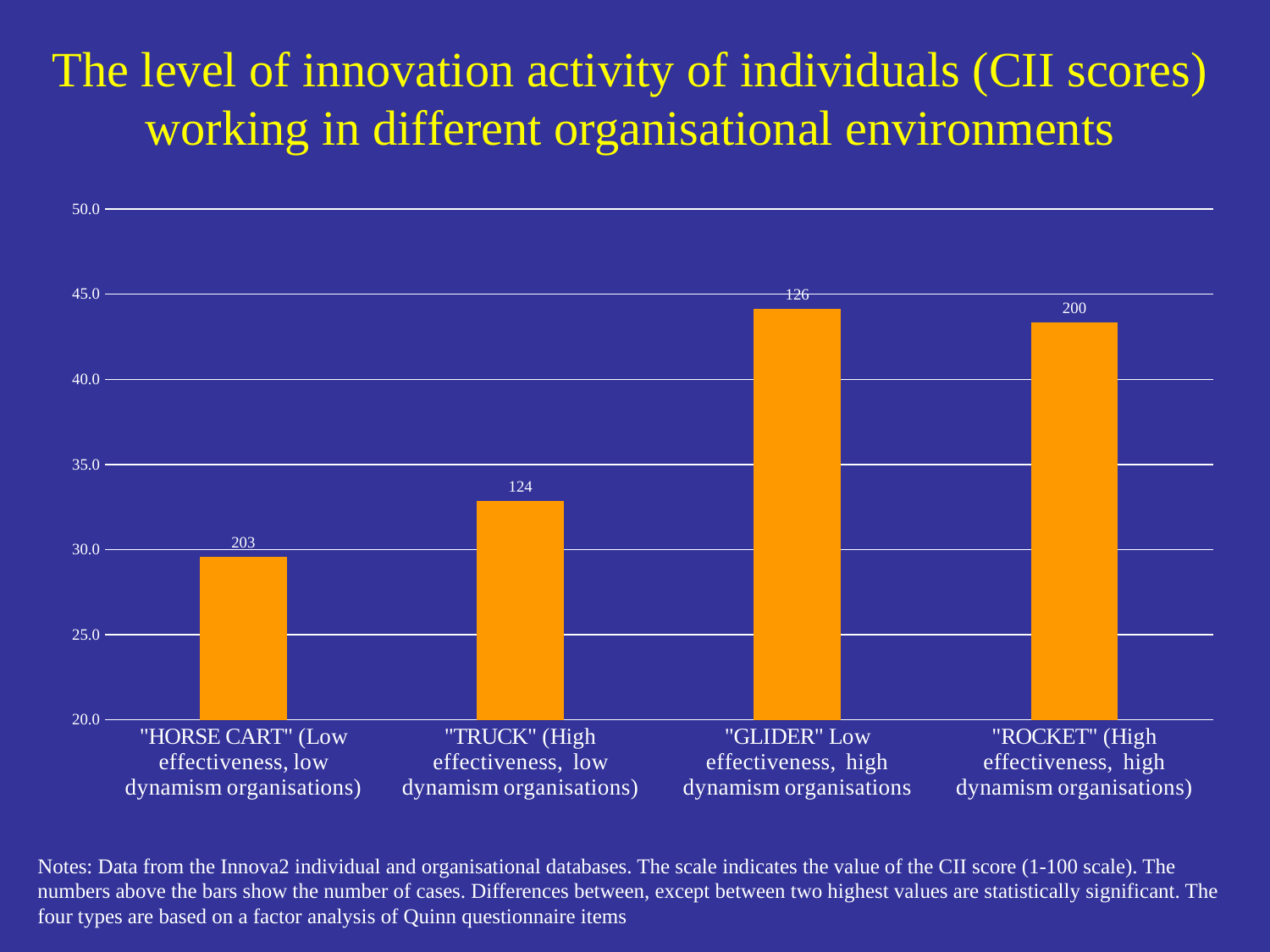
Is the CII score bar for "ROCKET" organisations greater or less than 45.0? less Which has the higher CII score bar, "TRUCK" or "HORSE CART" organisations? "TRUCK" What number of cases is printed above the bar for "HORSE CART" organisations? 203 What number of cases is printed above the bar for "ROCKET" organisations? 200 How many organisational types (bars) are shown in the chart? 4 What is the difference between the number of cases printed above the "HORSE CART" bar and the "ROCKET" bar? 3 Is the CII score bar for "TRUCK" organisations greater or less than 35.0? less Is the CII score bar for "GLIDER" organisations greater or less than 40.0? greater Which organisational type has the lowest CII score bar? "HORSE CART" (Low effectiveness, low dynamism organisations) What kind of chart is shown on the slide? bar chart What number of cases is printed above the bar for "TRUCK" organisations? 124